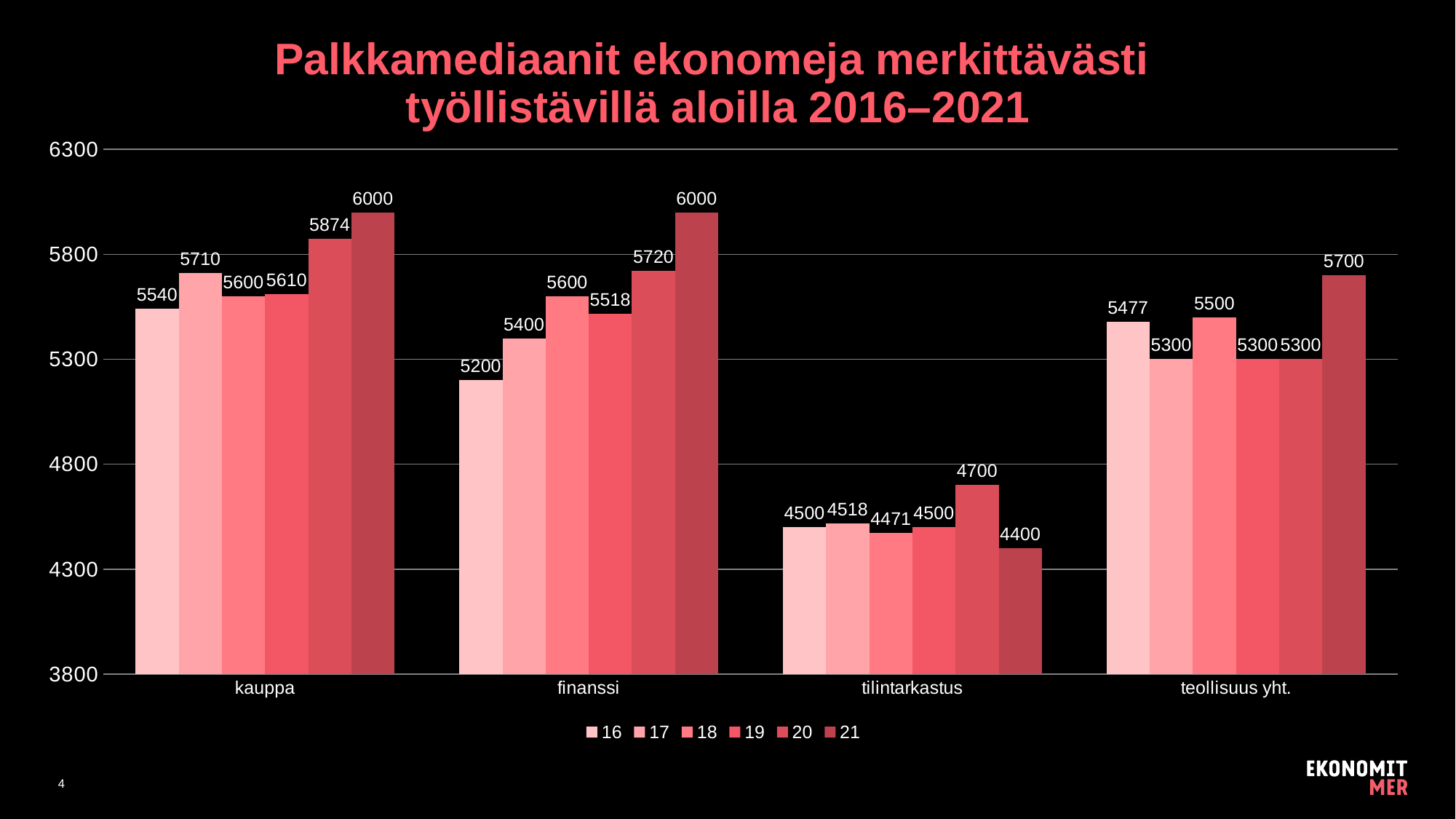
Which series has the lowest value in the tilintarkastus category? 21 What is the value for series 20 in the tilintarkastus category? 4700 What is the difference between the series 21 and series 16 values in the finanssi category? 800 Which is larger: the series 17 value for kauppa or the series 17 value for finanssi? kauppa What is the value for series 21 in the kauppa category? 6000 What is the value for series 18 in the teollisuus yht. category? 5500 How many categories are shown on the x axis? 4 What is the title of the chart? Palkkamediaanit ekonomeja merkittävästi työllistävillä aloilla 2016–2021 Which series has the highest value in the finanssi category? 21 How many series does the legend list? 6 What kind of chart is shown on the slide? bar chart What is the value for series 16 in the finanssi category? 5200